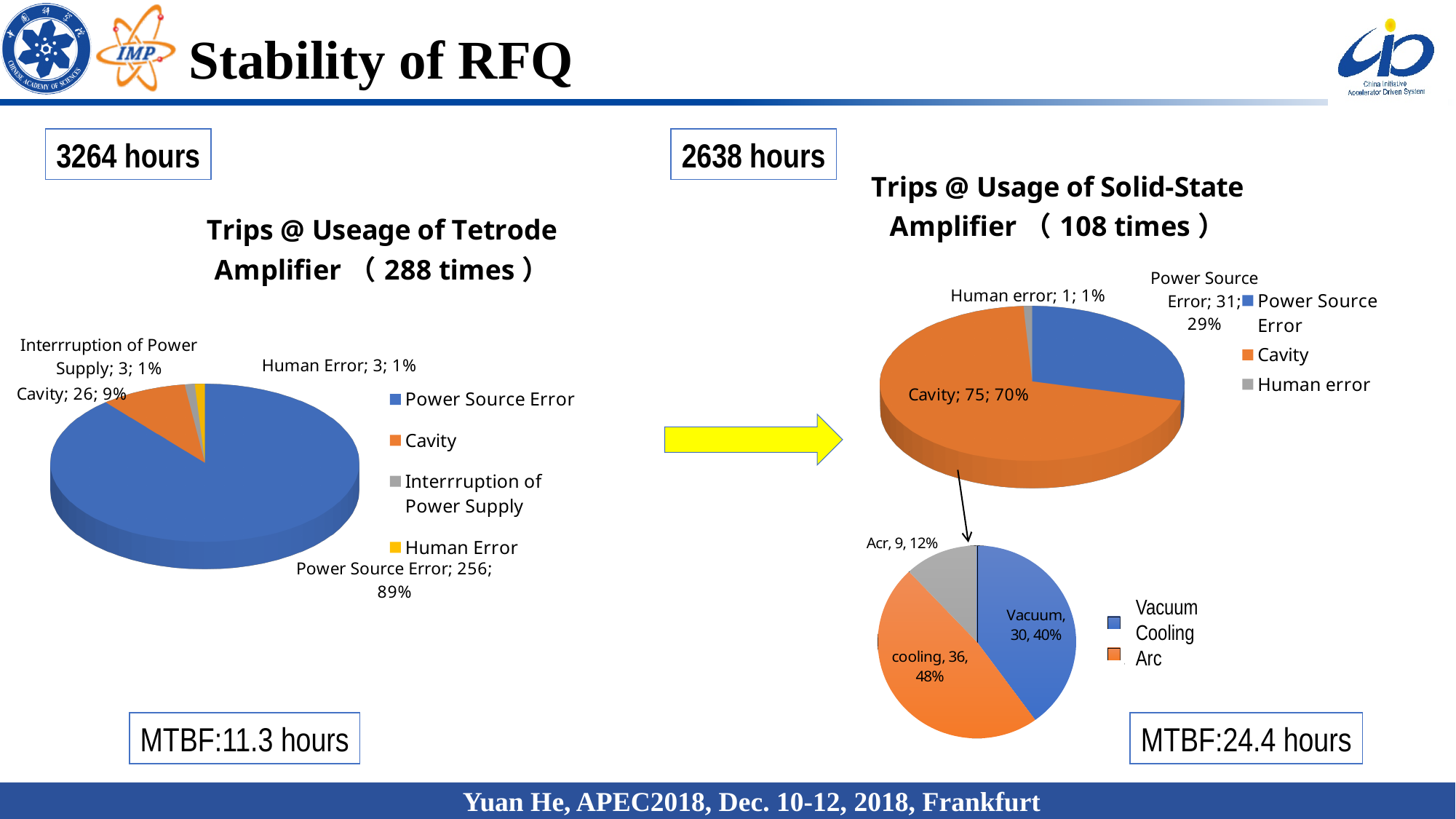
In the 'Trips @ Usage of Solid-State Amplifier' chart, which category has the smallest slice? Human error How many categories does the legend of the 'Trips @ Useage of Tetrode Amplifier' chart list? 4 In the 'Trips @ Usage of Solid-State Amplifier' chart, what is the difference between the Cavity count and the Power Source Error count? 44 In the 'Trips @ Usage of Solid-State Amplifier' chart, what share of the pie is Power Source Error? 29% In the small pie chart at the bottom right of the slide, which is larger, Vacuum or Arc? Vacuum In the small pie chart at the bottom right of the slide, how many trips are attributed to cooling? 36 In the small pie chart at the bottom right of the slide, what share of the pie is Arc? 12% In the 'Trips @ Useage of Tetrode Amplifier' chart, what share of the pie is Cavity? 9% In the 'Trips @ Useage of Tetrode Amplifier' chart, which category has the largest slice? Power Source Error In the 'Trips @ Usage of Solid-State Amplifier' chart, how many trips are attributed to Cavity? 75 In the 'Trips @ Useage of Tetrode Amplifier' chart, how many trips are attributed to Power Source Error? 256 What type of chart is used for 'Trips @ Useage of Tetrode Amplifier'? Pie chart